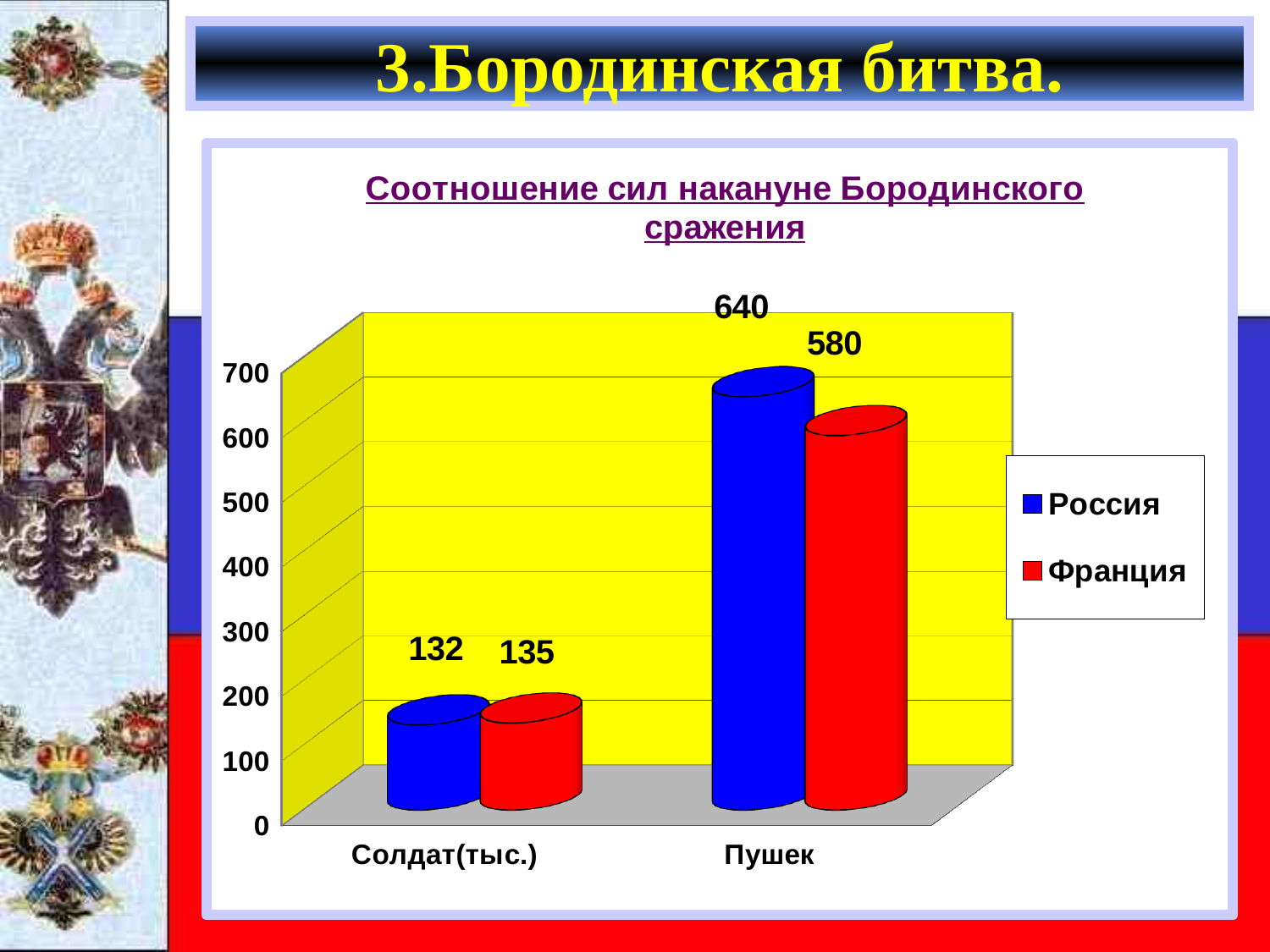
How many series does the legend list? 2 How many categories are shown on the x axis? 2 Which series has the higher value in the Пушек category? Россия What is the value for Россия in the Солдат(тыс.) category? 132 What is the value for Франция in the Пушек category? 580 What is the value for Франция in the Солдат(тыс.) category? 135 What is the difference between the Россия and Франция values in the Пушек category? 60 What is the value for Россия in the Пушек category? 640 What is the difference between the Франция and Россия values in the Солдат(тыс.) category? 3 What kind of chart is shown on the slide? bar chart What is the title of the chart? Соотношение сил накануне Бородинского сражения Which colour represents Франция in the chart? red